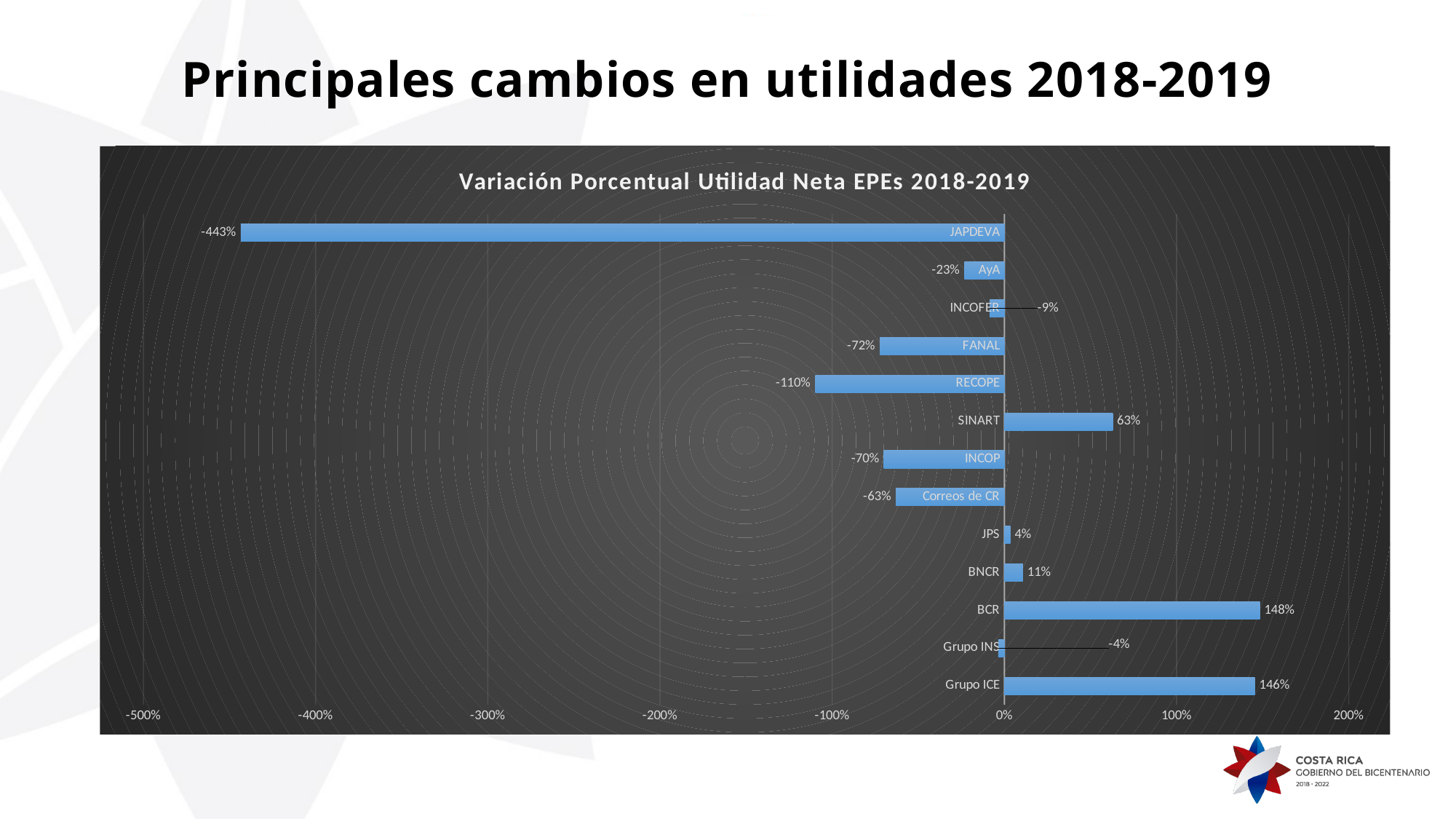
What is the value for RECOPE? -110% What kind of chart is shown on the slide? Bar chart Which category has the highest value? BCR What is the difference between the values for BCR and Grupo ICE? 2% Which is larger, the value for BNCR or the value for JPS? BNCR How many categories are shown in the chart? 13 What is the value for SINART? 63% What is the title of the chart? Variación Porcentual Utilidad Neta EPEs 2018-2019 What is the value for JAPDEVA? -443% What is the value for BCR? 148% What is the difference between the values for FANAL and INCOP? 2% Which category has the lowest value? JAPDEVA